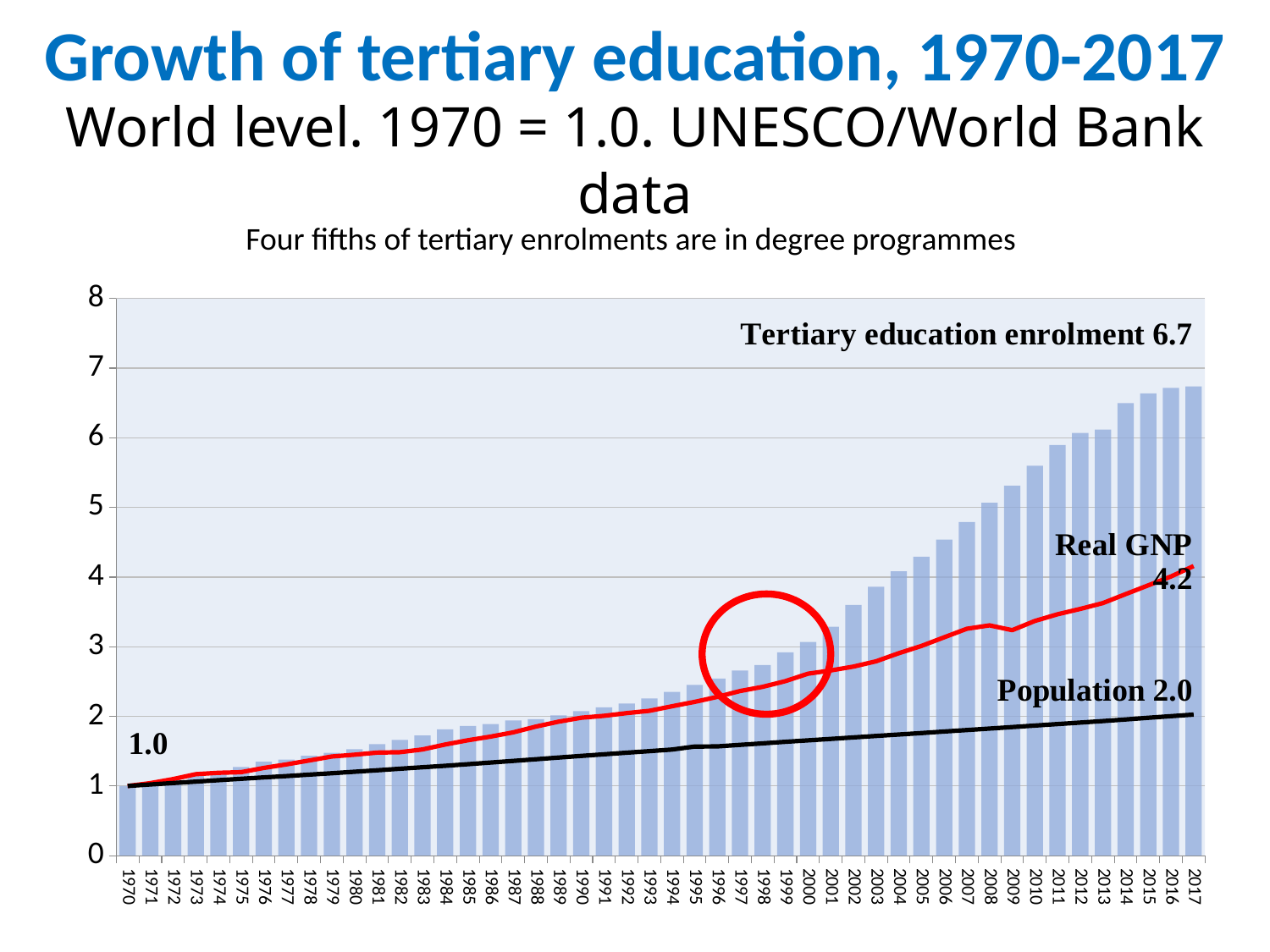
Do the tertiary education enrolment bars rise or fall from 1970 to 2017? rise Which year has the highest tertiary education enrolment bar? 2017 Is the tertiary education enrolment bar for 2000 greater or less than 4? less How many years are shown on the x axis of the chart? 48 What is the difference between the 2017 tertiary education enrolment value (6.7) and the 2017 Real GNP value (4.2)? 2.5 What is the tertiary education enrolment index value shown for 2017? 6.7 In 2017, which is larger: tertiary education enrolment or Real GNP? Tertiary education enrolment Is the tertiary education enrolment bar for 2010 greater or less than 5? greater What is the Real GNP index value shown for 2017? 4.2 What is the Population index value shown for 2017? 2.0 What is the index value labelled at the start of the series in 1970? 1.0 What is the difference between the 2017 Real GNP value (4.2) and the 2017 Population value (2.0)? 2.2